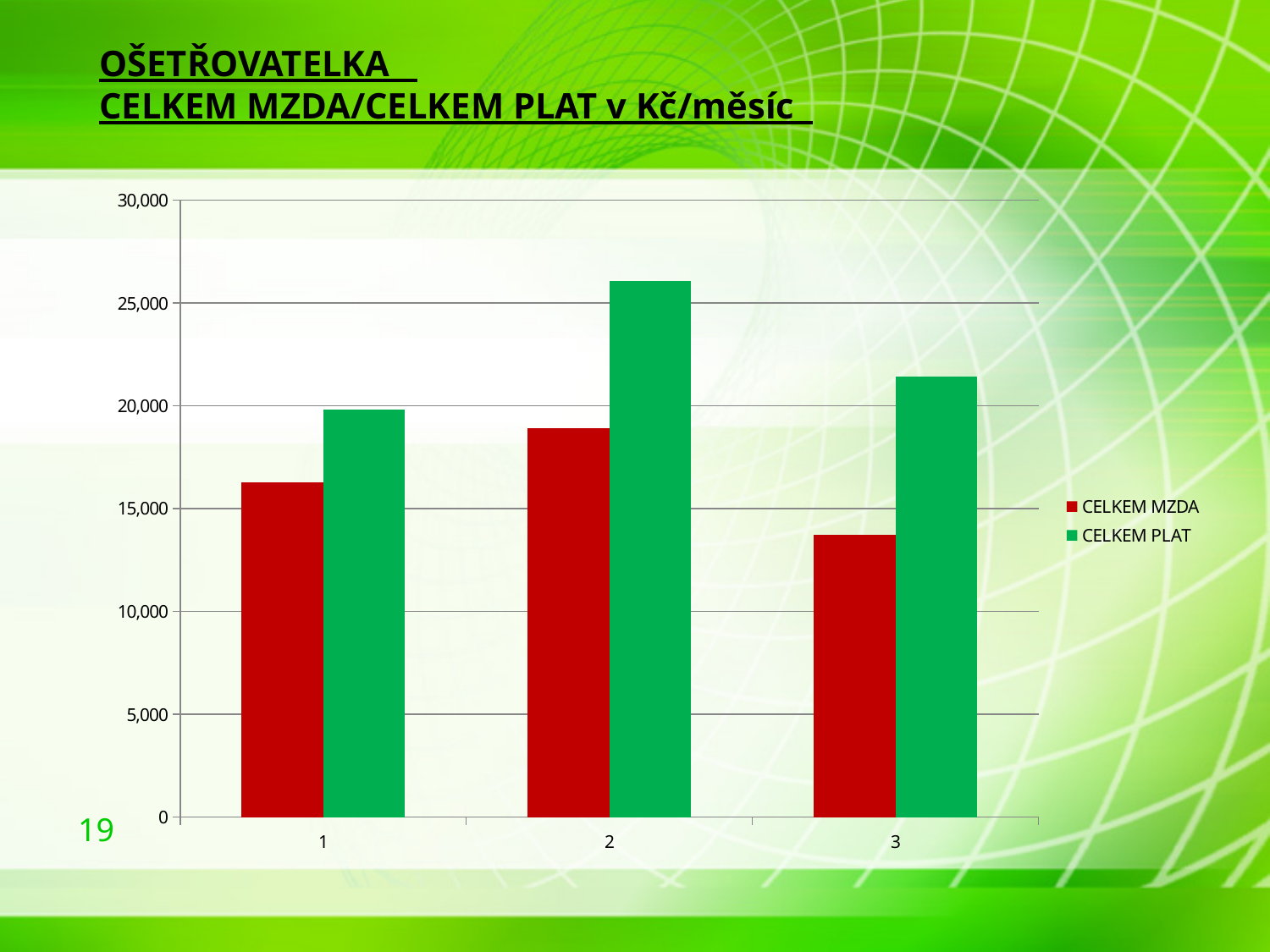
What colour are the CELKEM PLAT bars? green Which is larger: CELKEM MZDA for category 1 or CELKEM MZDA for category 3? CELKEM MZDA for category 1 Is the CELKEM PLAT value for category 2 greater or less than 25,000? greater How many categories are shown on the x axis? 3 Which category has the highest CELKEM PLAT value? 2 What kind of chart is shown on the slide? bar chart Which category has the lowest CELKEM MZDA value? 3 Which category has the lowest CELKEM PLAT value? 1 For category 2, which is larger: CELKEM MZDA or CELKEM PLAT? CELKEM PLAT How many series does the legend list? 2 Is the CELKEM MZDA value for category 3 greater or less than 15,000? less